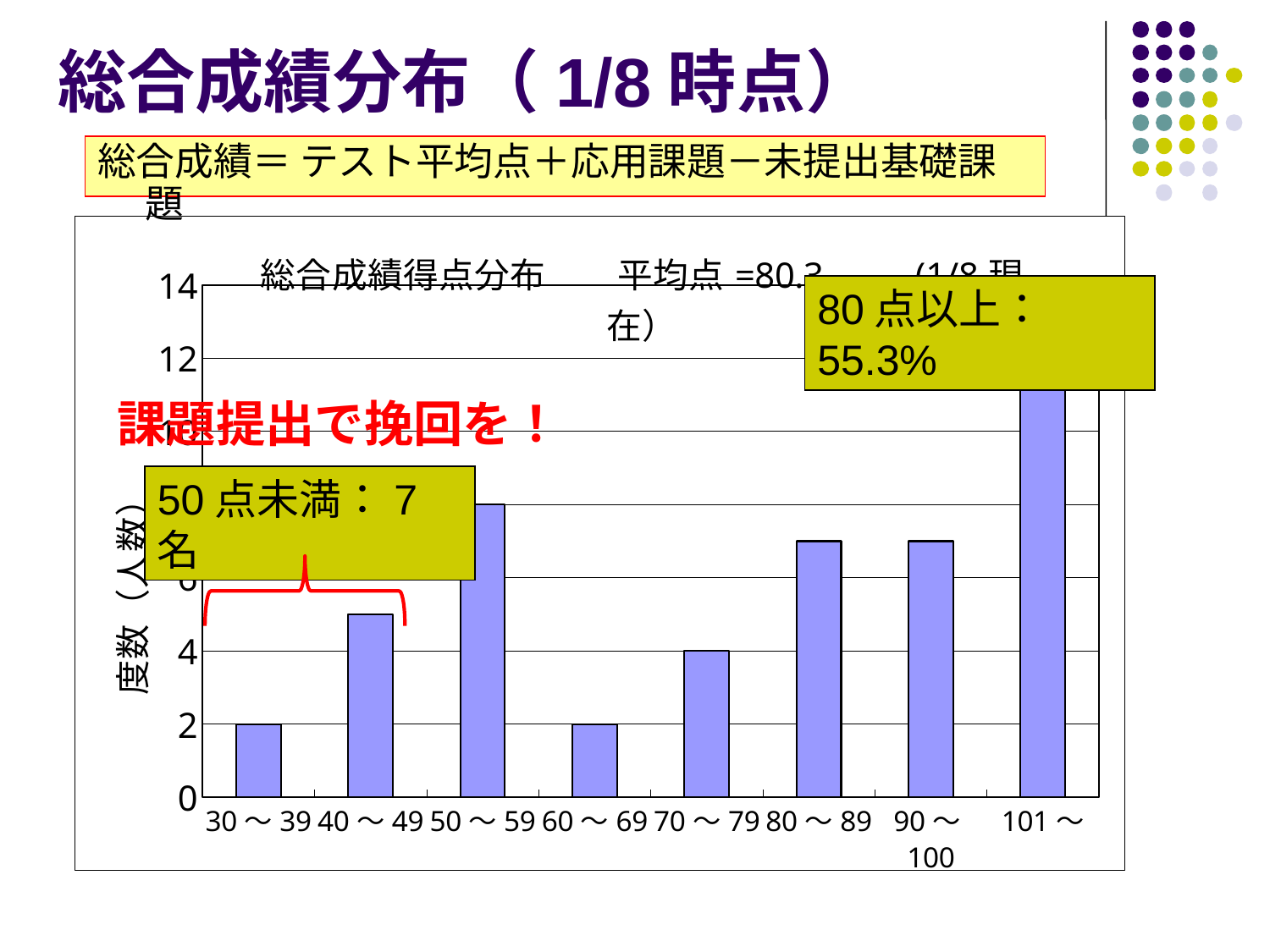
What kind of chart is shown on the slide? bar chart How many score-range categories are shown on the x axis? 8 What is the frequency for the 70～79 score range? 4 Is the frequency for the 80～89 score range greater or less than 6? greater What is the frequency (度数) for the 30～39 score range? 2 Which has the larger frequency, the 50～59 range or the 70～79 range? 50～59 Is the frequency for the 101～ score range greater or less than 10? greater What is the difference between the frequencies of the 50～59 and 70～79 score ranges? 4 What is the frequency for the 50～59 score range? 8 Is the frequency for the 40～49 score range greater or less than 4? greater Which score range has the highest frequency? 101～ What is the frequency for the 60～69 score range? 2